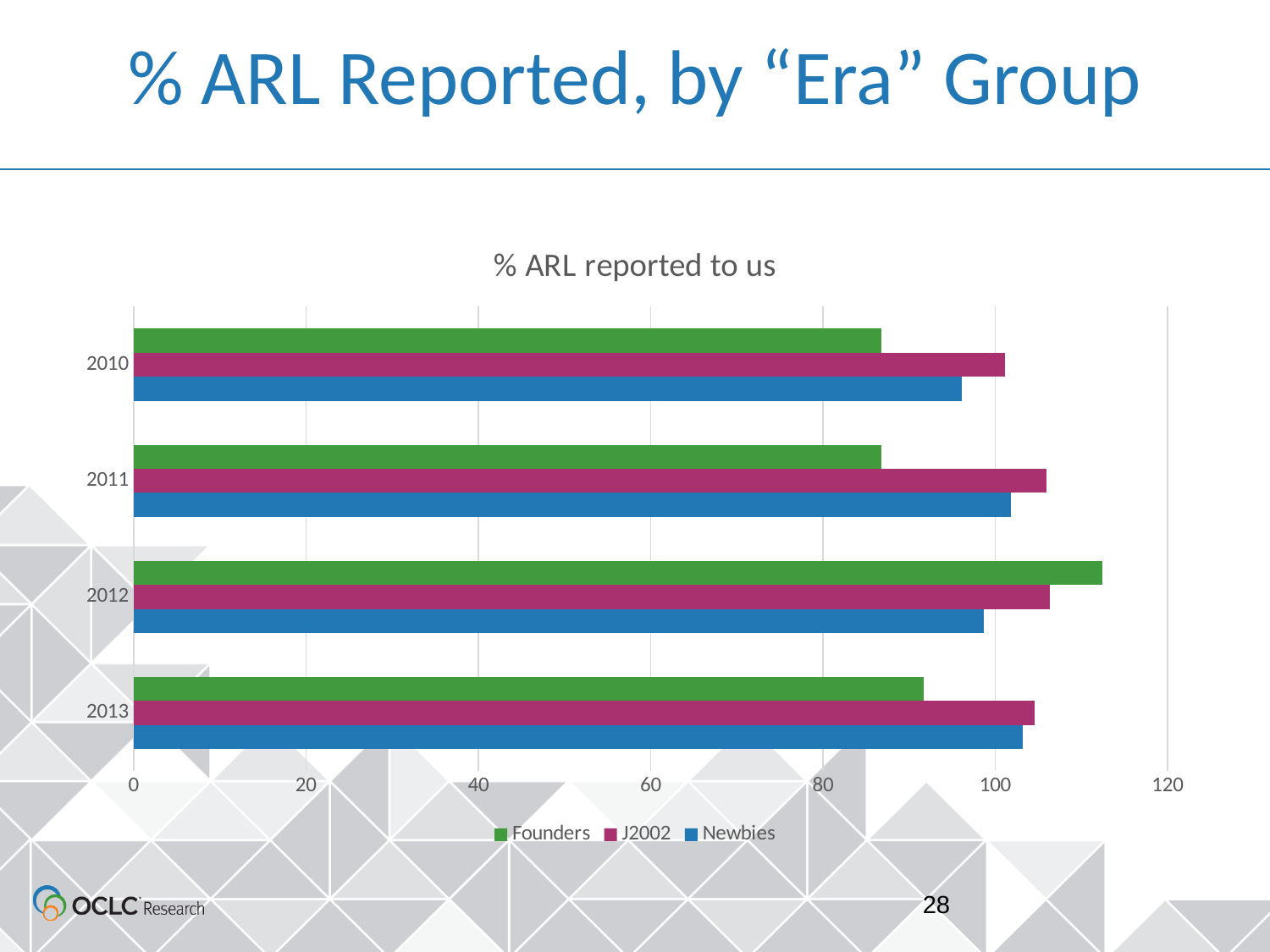
Is the Newbies value for 2010 greater or less than 100? less Is the J2002 value for 2011 greater or less than 100? greater For 2010, which is larger: the Founders value or the J2002 value? J2002 What is the title of the chart? % ARL reported to us Is the Founders value for 2012 greater or less than 100? greater What kind of chart is shown on the slide? Bar chart How many year categories are shown on the chart? 4 For 2012, which is larger: the Founders value or the Newbies value? Founders How many series does the legend list? 3 Which series is shown in green? Founders In which year is the Founders value highest? 2012